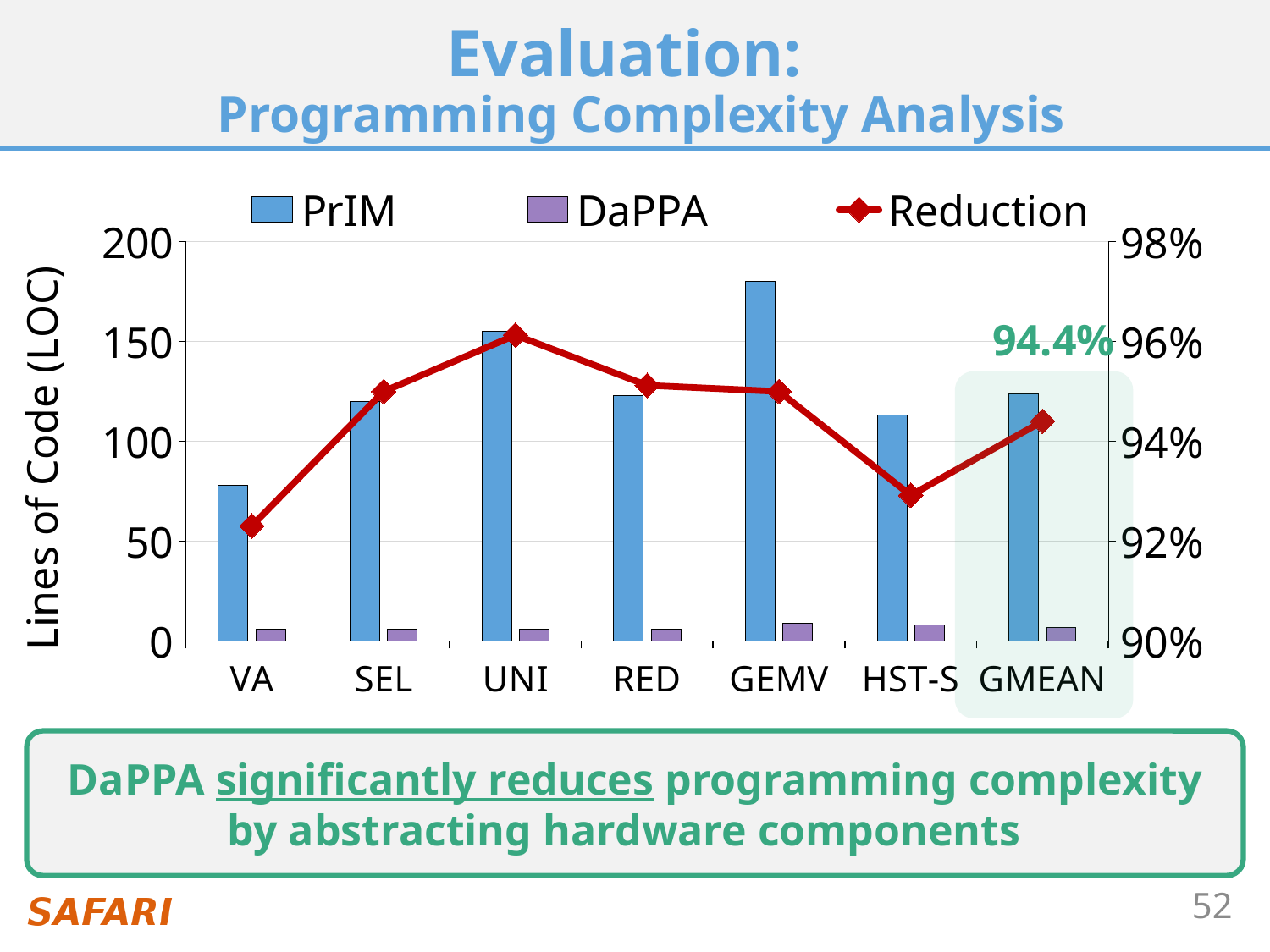
Which category has the highest Reduction percentage? UNI Is the PrIM value for VA greater or less than 100? less Which category has the highest PrIM lines of code? GEMV What is the Reduction value shown for GMEAN? 94.4% What kind of chart is shown on the slide? bar and line chart Is the Reduction value for VA greater or less than 94%? less How many series does the legend list? 3 What is the title of the left vertical axis? Lines of Code (LOC) Which has more PrIM lines of code, GEMV or UNI? GEMV How many categories are shown on the x axis? 7 Is the PrIM value for GEMV greater or less than 150? greater Which category has the lowest PrIM lines of code? VA